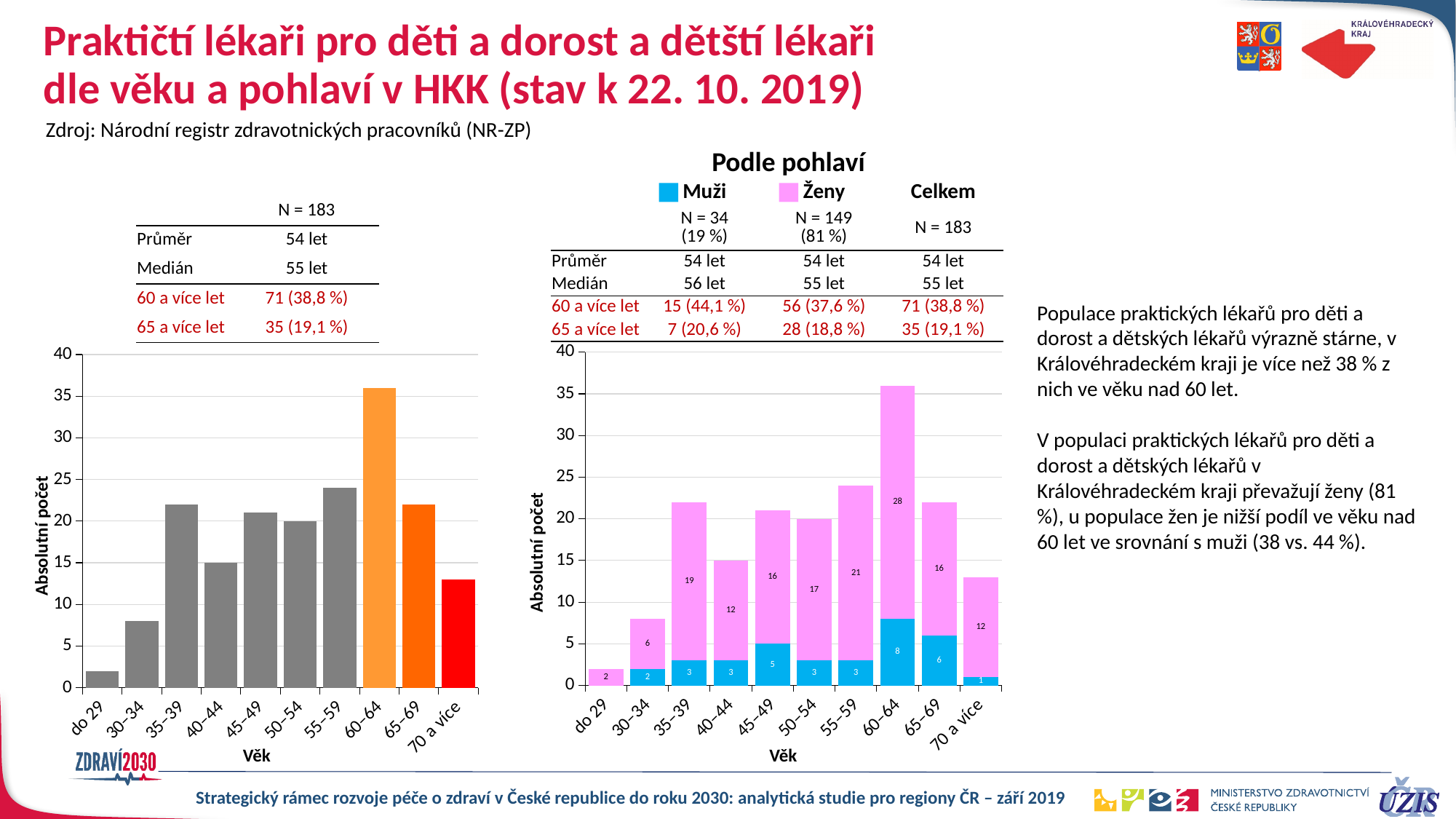
In the left chart, is the value for 35–39 greater or less than 20? greater In the right chart (Podle pohlaví), what is the total of the stacked bar for 65–69? 22 In the right chart (Podle pohlaví), what is the Muži value for the 45–49 age group? 5 In the left chart, which age category has the lowest bar? do 29 In the left chart, which age category has the highest bar? 60–64 In the left chart, is the value for 30–34 greater or less than 10? less In the right chart (Podle pohlaví), what is the difference between the Ženy and Muži values for 60–64? 20 In the right chart (Podle pohlaví), what is the Ženy value for the 60–64 age group? 28 In the right chart (Podle pohlaví), which colour represents Muži? blue How many age categories are shown on the x axis of the left chart? 10 What kind of chart is the left chart? bar chart How many series does the legend of the right chart (Podle pohlaví) list? 2